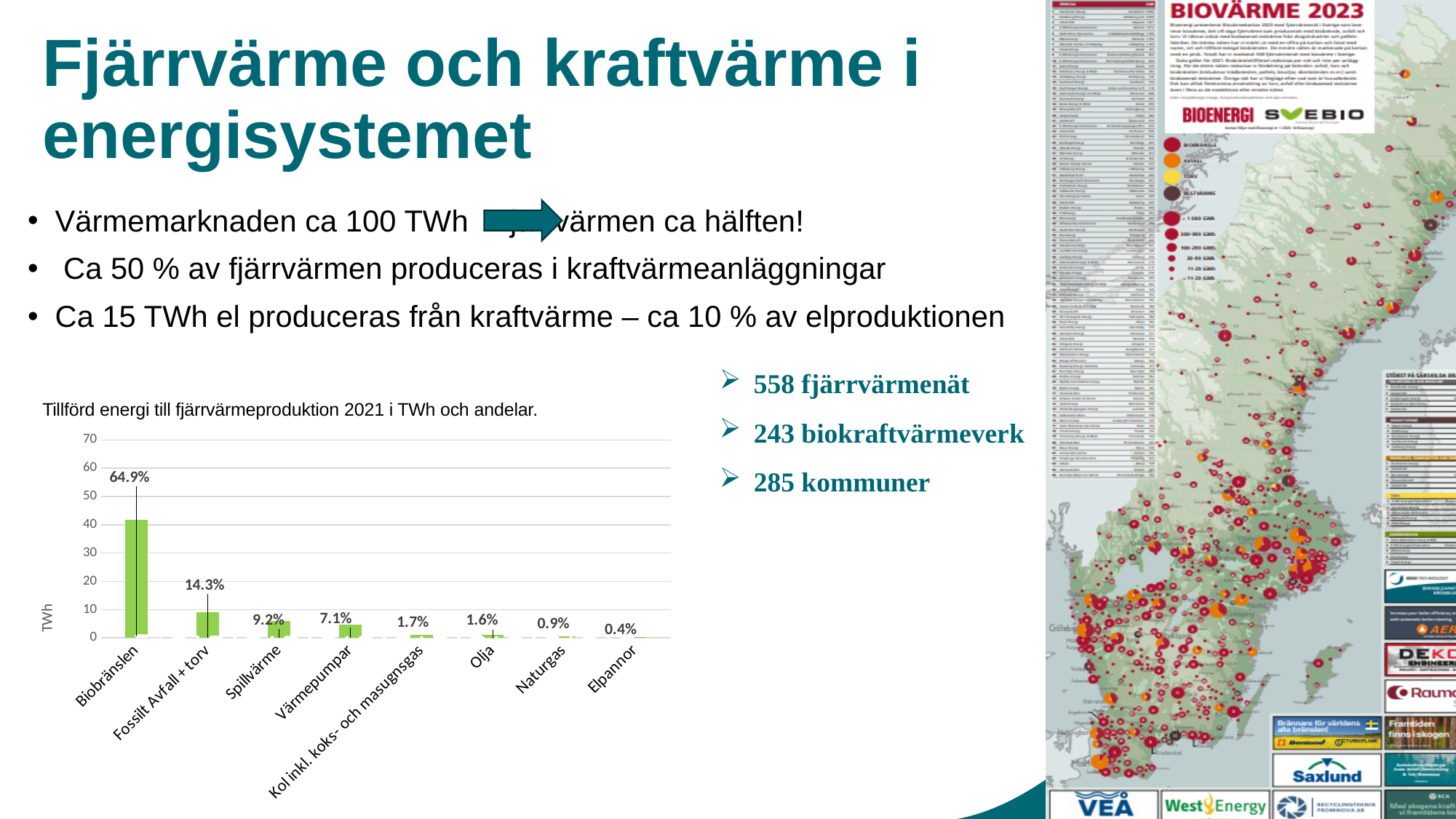
What percentage label is shown for Biobränslen in the chart? 64.9% Which category has the highest value in the chart? Biobränslen Is the value in TWh for Biobränslen greater or less than 30? greater What is the title of the chart? Tillförd energi till fjärrvärmeproduktion 2021 i TWh och andelar. What percentage label is shown for Fossilt Avfall + torv? 14.3% Which category has the lowest value in the chart? Elpannor What percentage label is shown for Naturgas? 0.9% What is the difference in percentage points between the labels for Biobränslen and Fossilt Avfall + torv? 50.6 How many categories are shown on the x axis of the chart? 8 Which has a larger share, Spillvärme or Värmepumpar? Spillvärme What kind of chart is shown on the slide? Bar chart What percentage label is shown for Värmepumpar? 7.1%